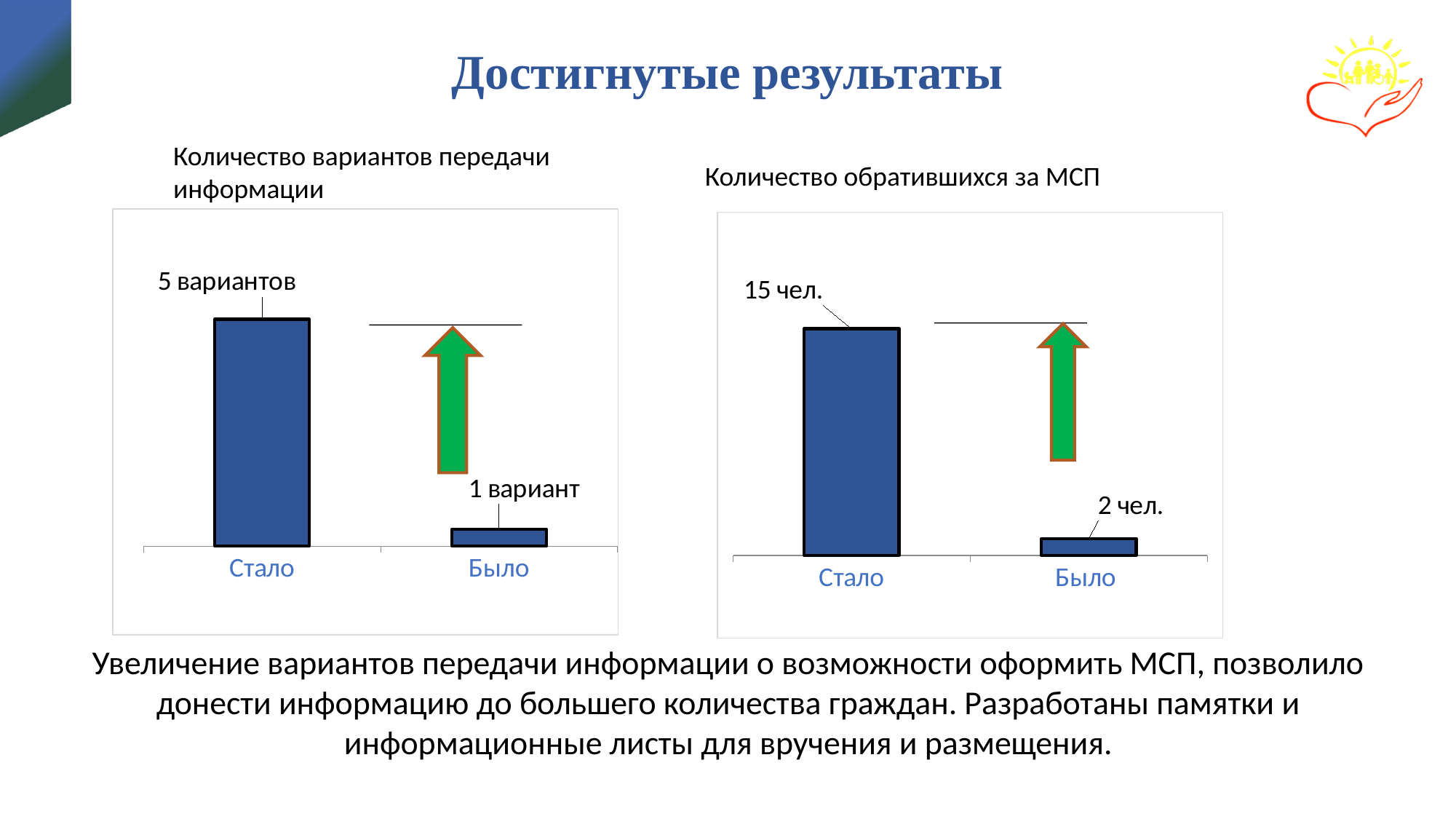
In the chart 'Количество обратившихся за МСП', what is the difference between 'Стало' and 'Было'? 13 чел. In the chart 'Количество обратившихся за МСП', what is the value for 'Было'? 2 чел. How many charts are shown on the slide? 2 In the chart 'Количество вариантов передачи информации', what is the value for 'Было'? 1 вариант In the chart 'Количество вариантов передачи информации', what is the difference between 'Стало' and 'Было'? 4 In the chart 'Количество обратившихся за МСП', which is larger, 'Стало' or 'Было'? Стало In the chart 'Количество обратившихся за МСП', which category has the highest value? Стало In the chart 'Количество вариантов передачи информации', what is the value for 'Стало'? 5 вариантов How many categories does the chart 'Количество вариантов передачи информации' show? 2 In the chart 'Количество обратившихся за МСП', what is the value for 'Стало'? 15 чел. What kind of chart is 'Количество обратившихся за МСП'? Bar chart In the chart 'Количество вариантов передачи информации', which category has the lowest value? Было